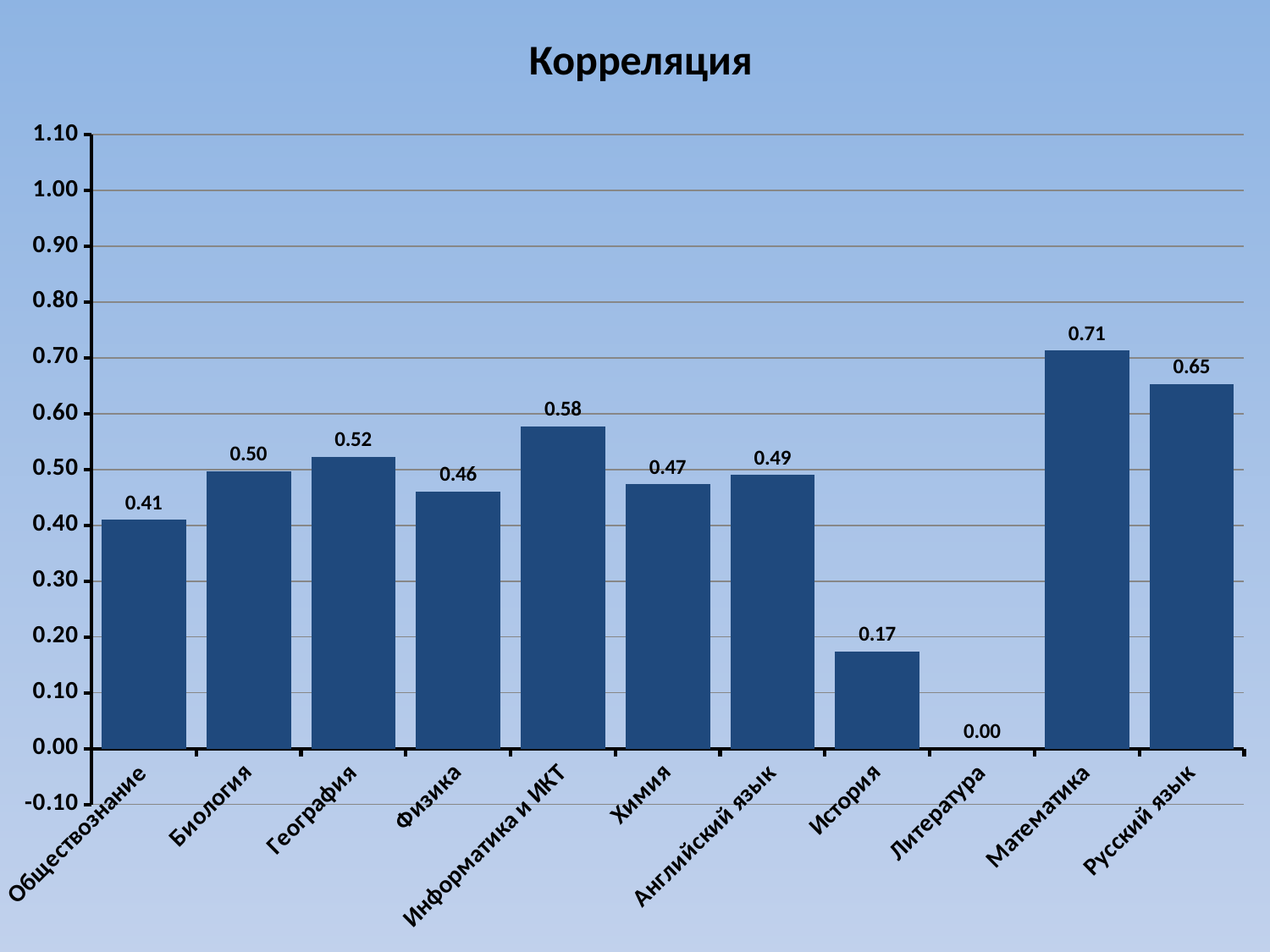
Which is larger, the value for География or the value for Физика? География What is the title of the chart? Корреляция Which category has the lowest value? Литература What is the value for История? 0.17 Which category has the highest value? Математика What is the value for Информатика и ИКТ? 0.58 What is the difference between the values for Математика and Русский язык? 0.06 Is the value for Обществознание greater or less than 0.50? less How many categories are shown on the x axis? 11 What is the value for Математика? 0.71 What kind of chart is shown on the slide? bar chart What is the difference between the values for Информатика и ИКТ and История? 0.41